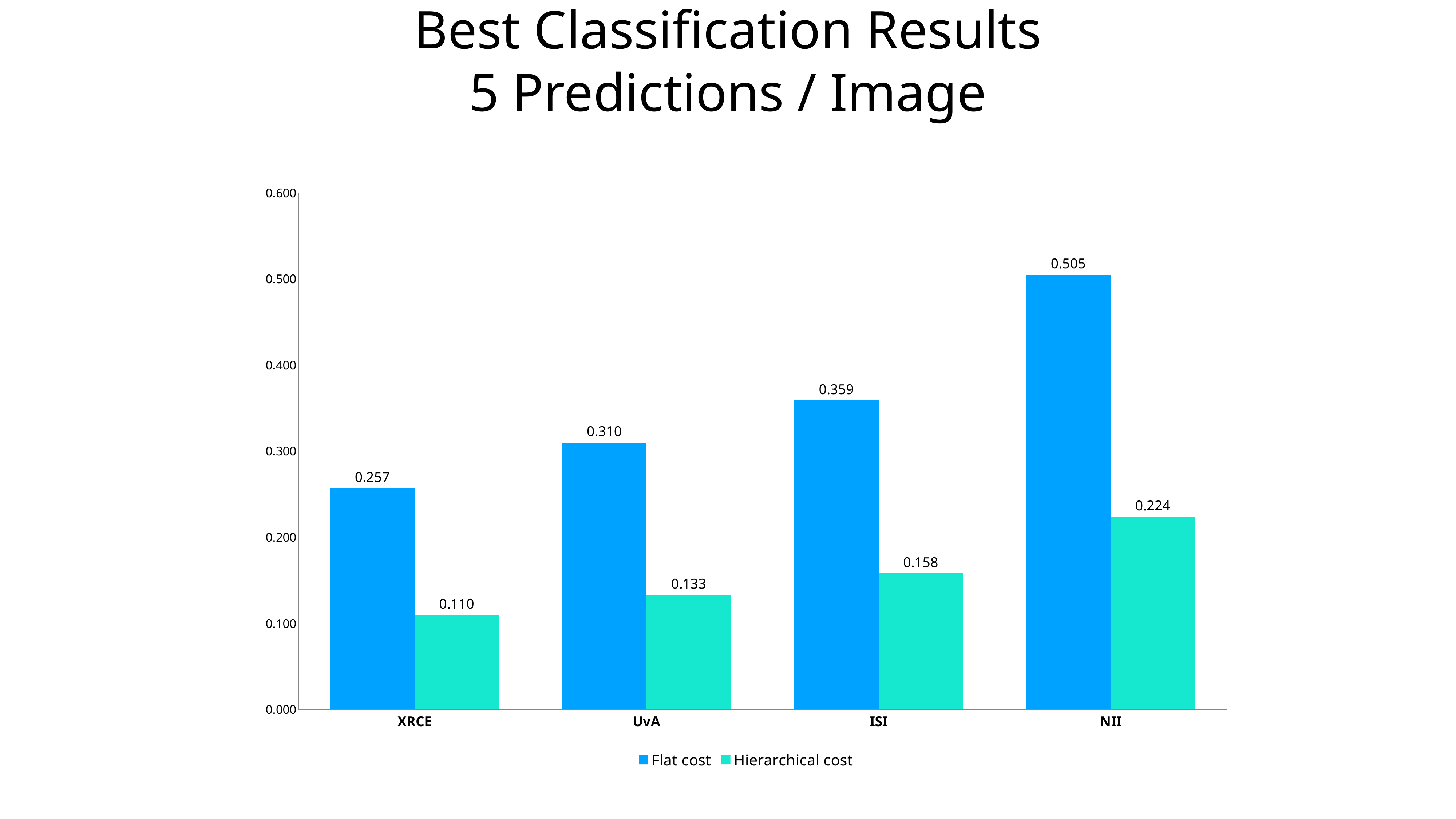
What is the difference between the Flat cost and Hierarchical cost for ISI? 0.201 Do the Flat cost values rise or fall from XRCE to NII? rise Which category has the highest Flat cost? NII What is the Hierarchical cost value for UvA? 0.133 What kind of chart is shown on the slide? bar chart What is the Flat cost value for XRCE? 0.257 Is the Hierarchical cost for NII greater or less than 0.200? greater How many categories are shown on the x axis? 4 Which category has the lowest Hierarchical cost? XRCE Which is larger, the Flat cost for UvA or the Flat cost for ISI? ISI How many series does the legend list? 2 What is the Flat cost value for NII? 0.505